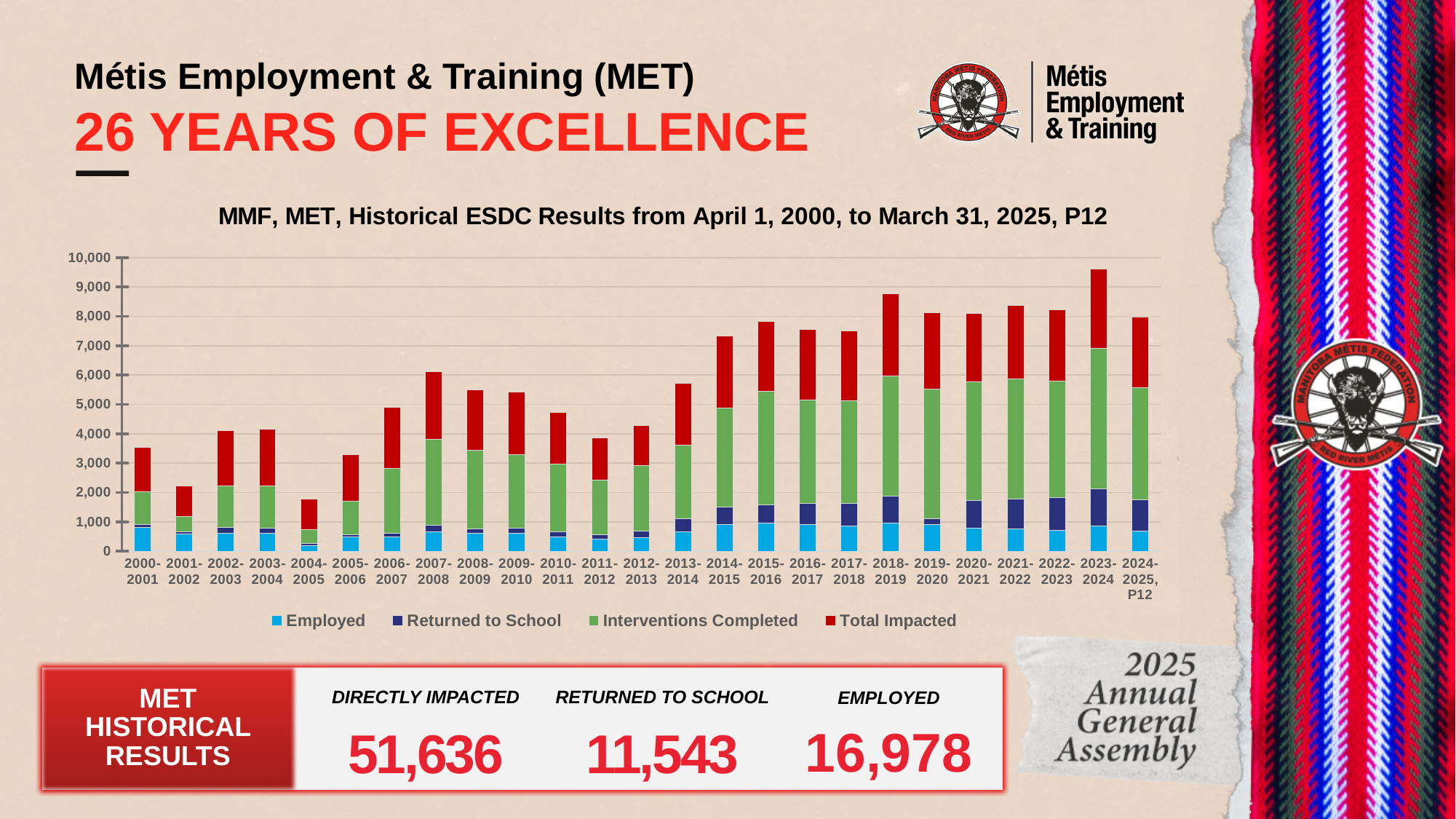
How many series does the chart legend list? 4 Which stacked bar is taller, 2001-2002 or 2002-2003? 2002-2003 Which stacked bar is taller, 2018-2019 or 2019-2020? 2018-2019 What kind of chart is shown on the slide? Stacked bar chart Is the top of the stacked bar for 2018-2019 greater or less than 8,000? greater Is the top of the stacked bar for 2023-2024 greater or less than 9,000? greater Which fiscal year has the shortest stacked bar? 2004-2005 Which fiscal year has the tallest stacked bar? 2023-2024 Is the top of the stacked bar for 2004-2005 greater or less than 2,000? less How many fiscal-year categories are plotted along the x axis? 25 Which colour represents the Total Impacted series in the legend? Red What is the title of the chart? MMF, MET, Historical ESDC Results from April 1, 2000, to March 31, 2025, P12